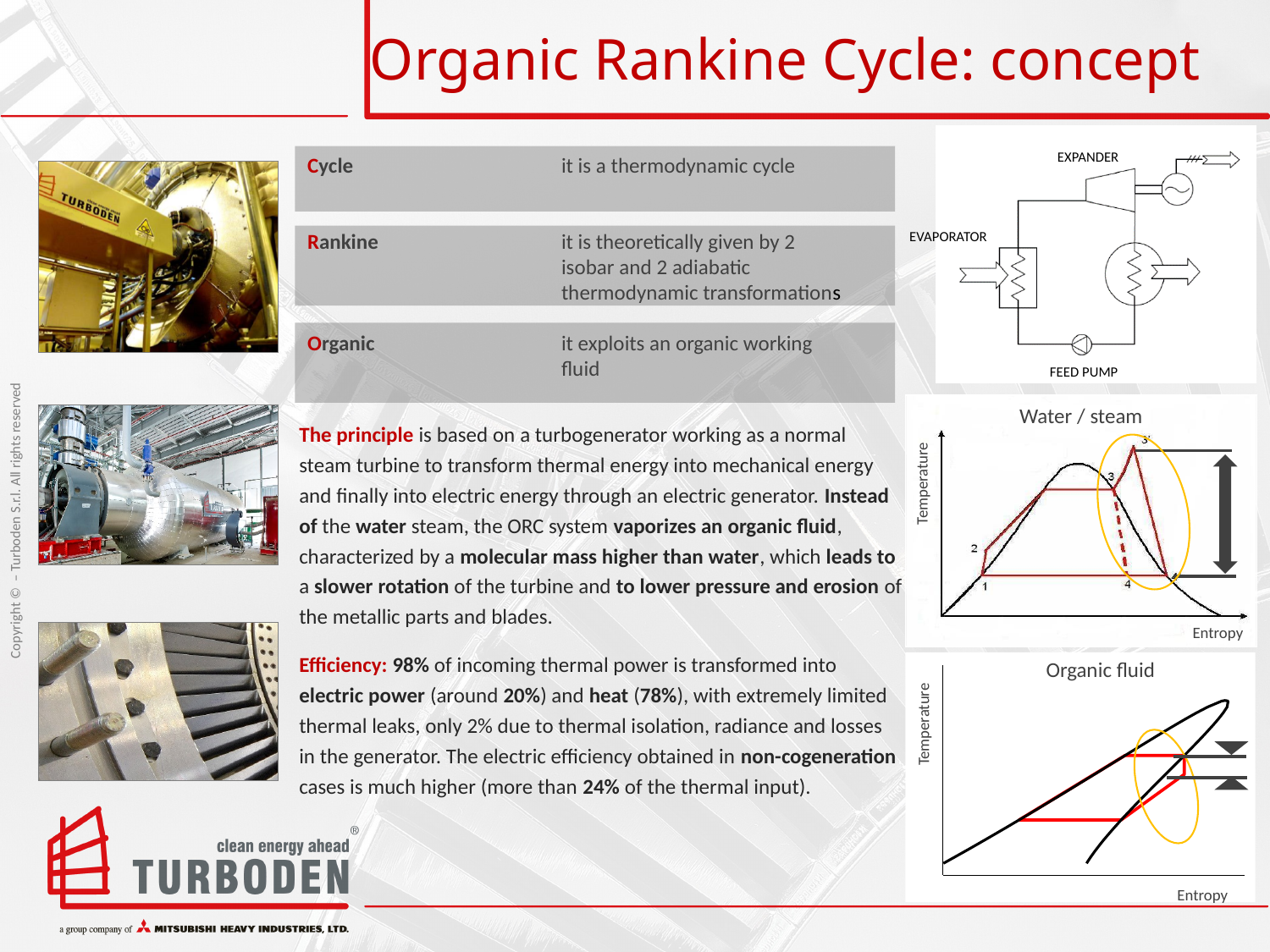
In the Organic fluid diagram, what quantity is plotted on the vertical axis? Temperature What is the title of the lower temperature-entropy diagram on the right side of the slide? Organic fluid What is the title of the upper temperature-entropy diagram on the right side of the slide? Water / steam In the Water / steam diagram, is the temperature of point 3 higher or lower than that of point 2? higher In the Water / steam diagram, which labelled state point is at the highest temperature? 3' What kind of chart is the Organic fluid diagram? line chart How many numbered state points are labelled on the Water / steam diagram? 5 In the Water / steam diagram, what quantity is plotted on the horizontal axis? Entropy In the Water / steam diagram, which labelled state point is at the lowest temperature? 1 and 4